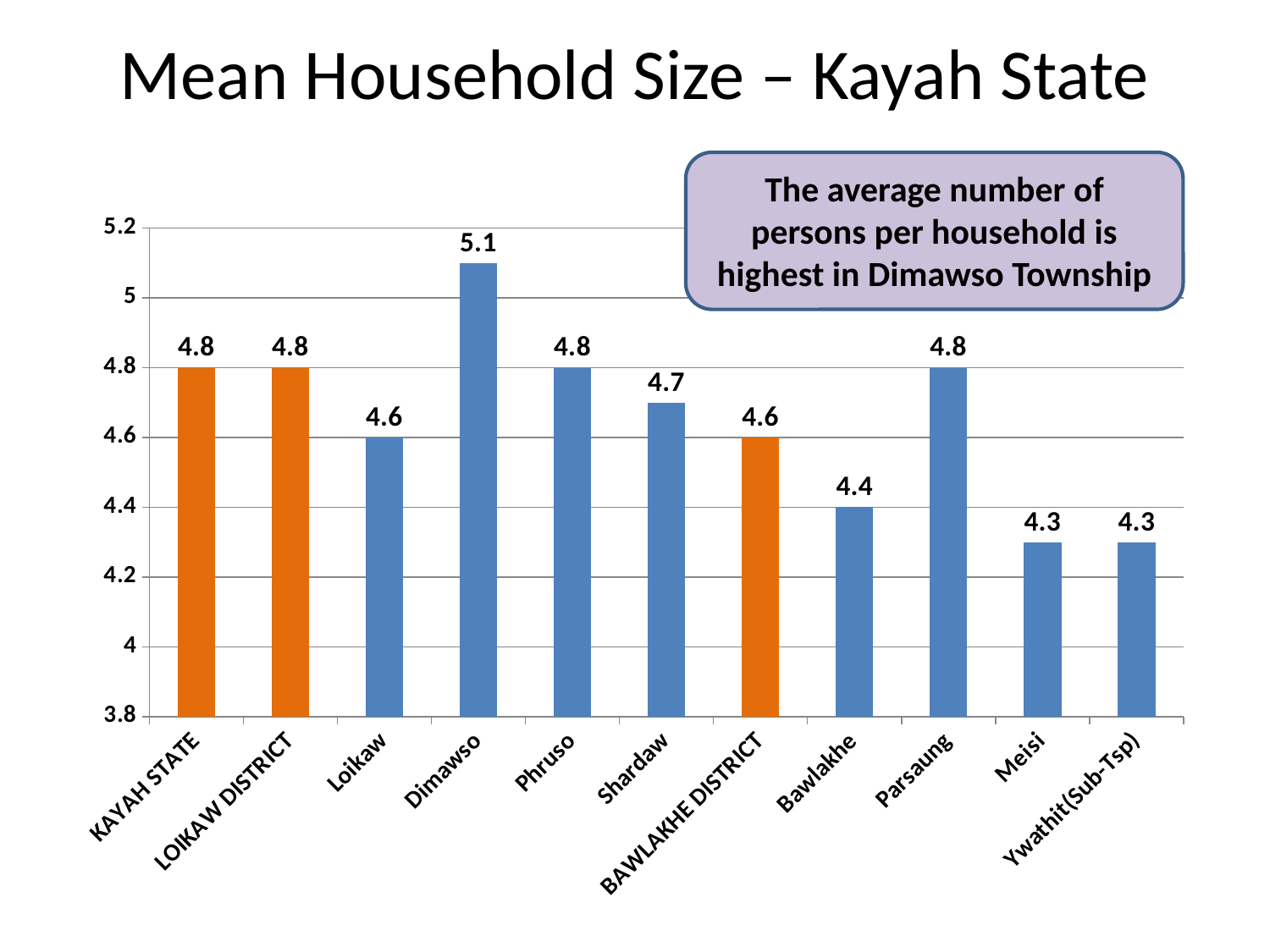
What is the difference between the mean household size of BAWLAKHE DISTRICT and LOIKAW DISTRICT? 0.2 What is the mean household size for Shardaw? 4.7 Which category has the highest mean household size? Dimawso How many categories are shown on the x axis? 11 What kind of chart is shown on the slide? Bar chart What colour are the bars for KAYAH STATE, LOIKAW DISTRICT and BAWLAKHE DISTRICT? Orange Which has a larger mean household size, Loikaw or Parsaung? Parsaung What is the mean household size for KAYAH STATE? 4.8 What is the mean household size for Dimawso? 5.1 What is the difference between the mean household size of Dimawso and Meisi? 0.8 What is the mean household size for Bawlakhe? 4.4 What is the title of the slide? Mean Household Size – Kayah State